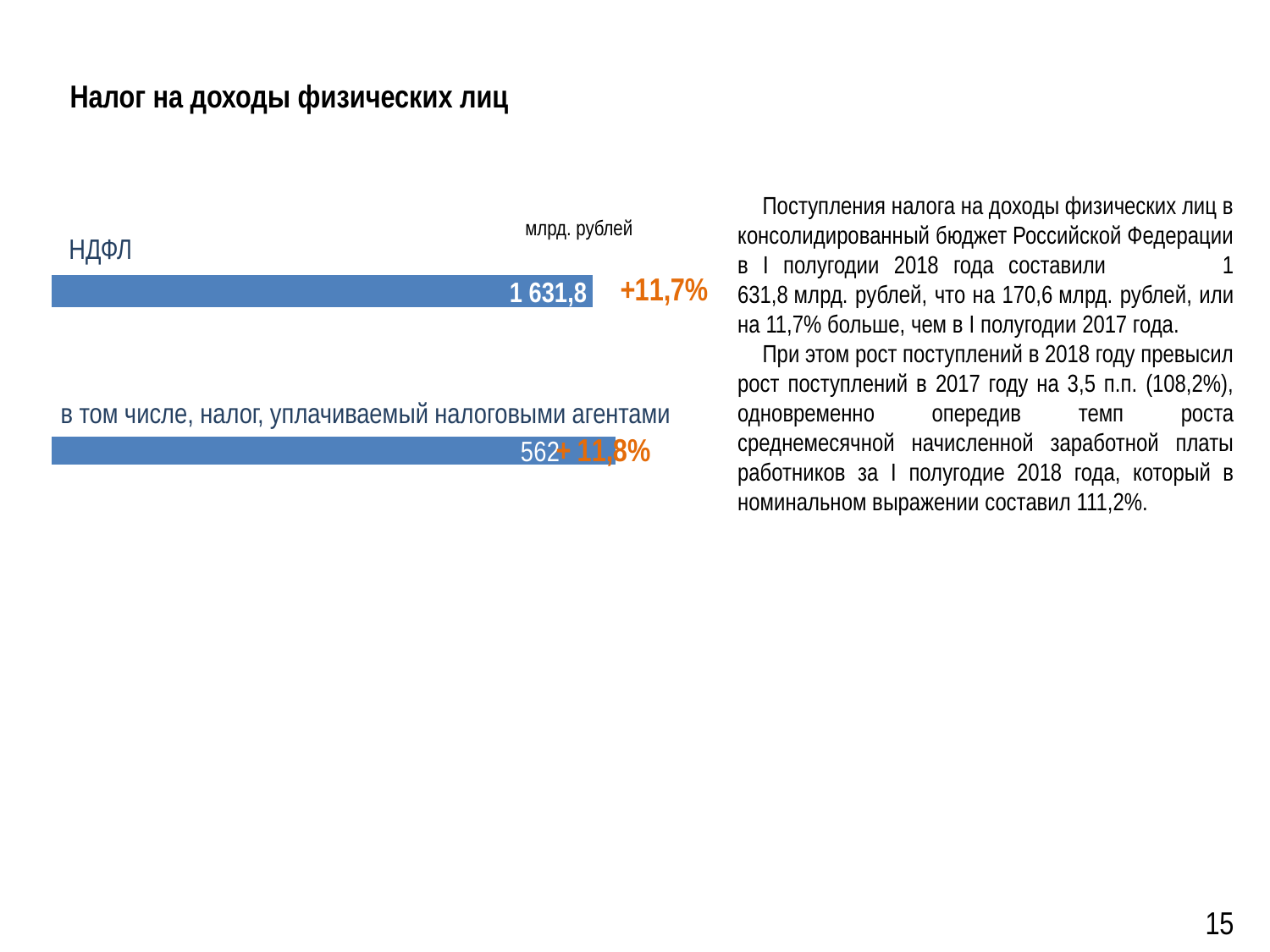
What growth percentage is shown next to the bar for налог, уплачиваемый налоговыми агентами? + 11,8% What colour are the bars on the chart? blue How many bars are shown on the chart? 2 What kind of chart is shown on the slide? bar chart Which of the two growth percentages shown is larger: +11,7% for НДФЛ or + 11,8% for налог, уплачиваемый налоговыми агентами? + 11,8% What growth percentage is shown next to the НДФЛ bar? +11,7% What unit of measurement is indicated above the chart? млрд. рублей What is the value shown for НДФЛ on the bar chart? 1 631,8 Is the value for НДФЛ greater or less than 1 000 млрд. рублей? greater